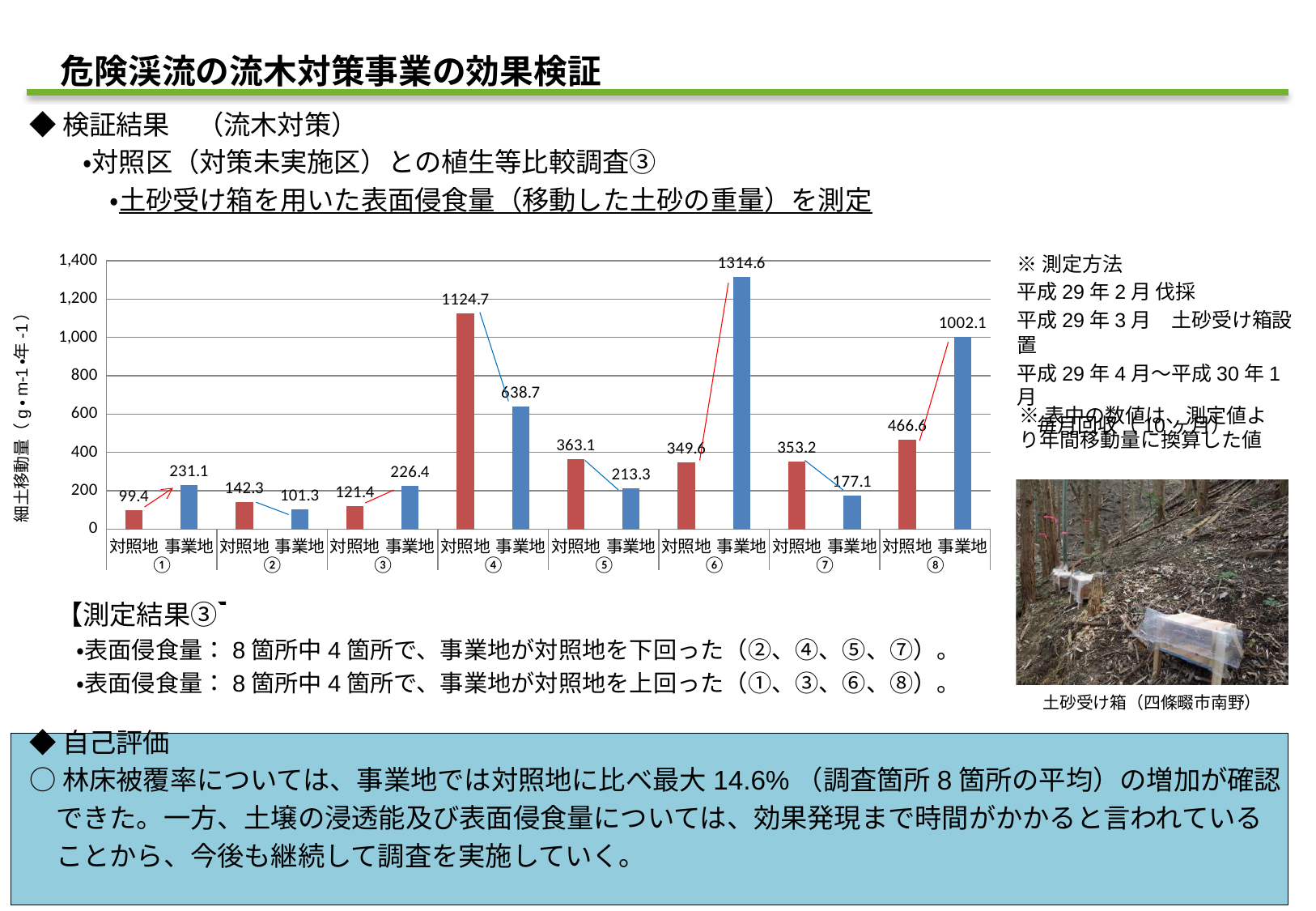
What is the value for 対照地 at site ⑧? 466.6 At site ⑤, which is larger, 対照地 or 事業地? 対照地 Which bar has the lowest value in the chart? 対照地 at site ① (99.4) What is the difference between 事業地 and 対照地 at site ⑧? 535.5 At site ③, which is larger, 対照地 or 事業地? 事業地 What is the value for 事業地 at site ①? 231.1 What is the value for 事業地 at site ⑥? 1314.6 How many numbered sites are shown on the x axis of the chart? 8 Which bar has the highest value in the chart? 事業地 at site ⑥ (1314.6) What is the difference between 対照地 and 事業地 at site ④? 486.0 What type of chart is shown on the slide? Bar chart What is the value for 対照地 at site ④? 1124.7